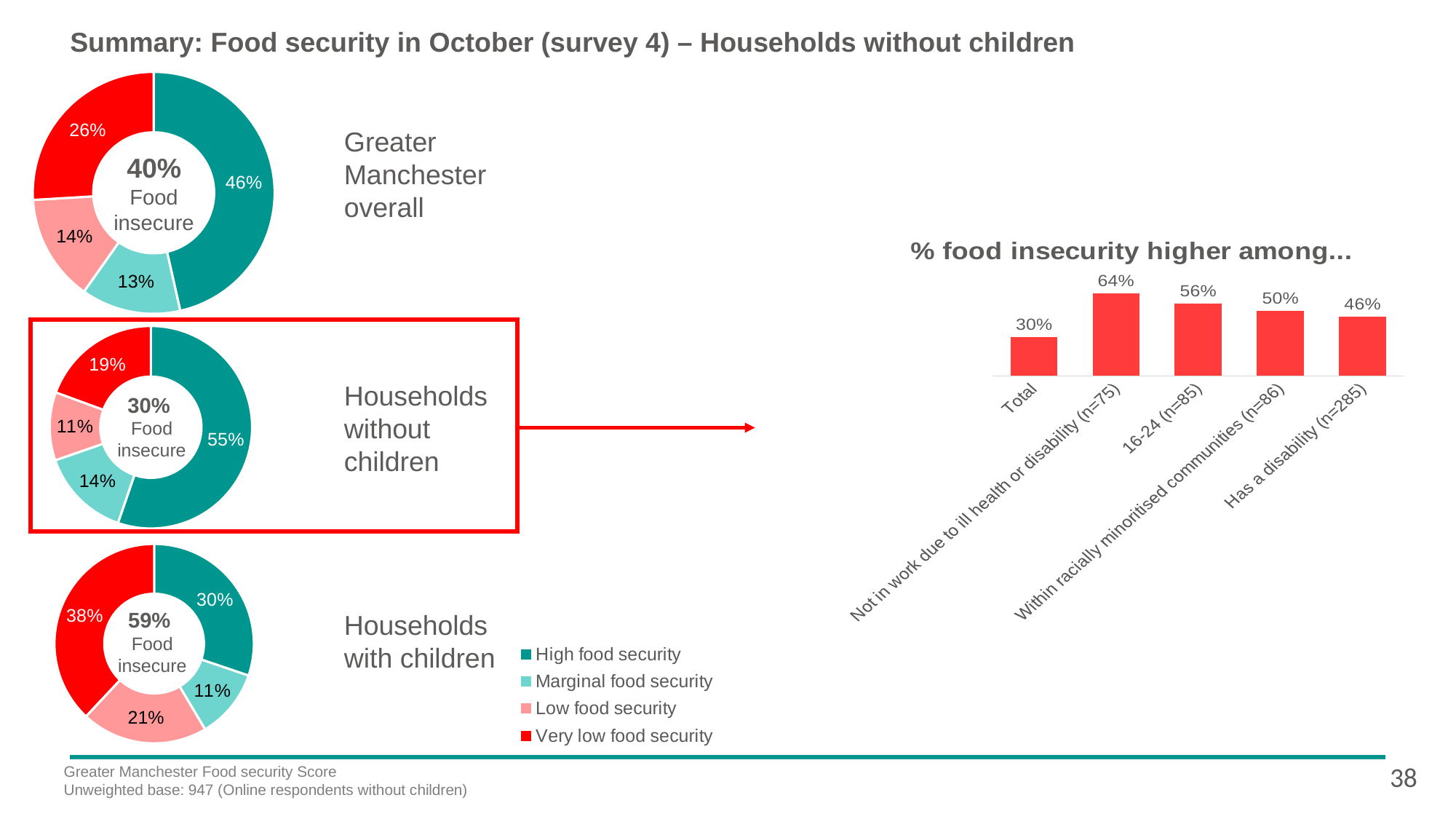
What kind of chart is the '% food insecurity higher among...' chart? Bar chart How many entries does the legend for the donut charts list? 4 In the 'Households with children' donut chart, which segment is the largest? Very low food security In the 'Households without children' donut chart, what share is 'High food security'? 55% In the bar chart titled '% food insecurity higher among...', what is the difference between the values for '16-24 (n=85)' and 'Total'? 26% In the bar chart titled '% food insecurity higher among...', what is the value for 'Not in work due to ill health or disability (n=75)'? 64% In the bar chart titled '% food insecurity higher among...', how many bars are shown? 5 In the bar chart titled '% food insecurity higher among...', which is larger: the value for 'Within racially minoritised communities (n=86)' or 'Has a disability (n=285)'? Within racially minoritised communities (n=86) In the 'Households without children' donut chart, what share is 'Very low food security'? 19% In the bar chart titled '% food insecurity higher among...', which category has the lowest value? Total In the bar chart titled '% food insecurity higher among...', which category has the highest value? Not in work due to ill health or disability (n=75) In the 'Greater Manchester overall' donut chart, what share is 'Low food security'? 14%